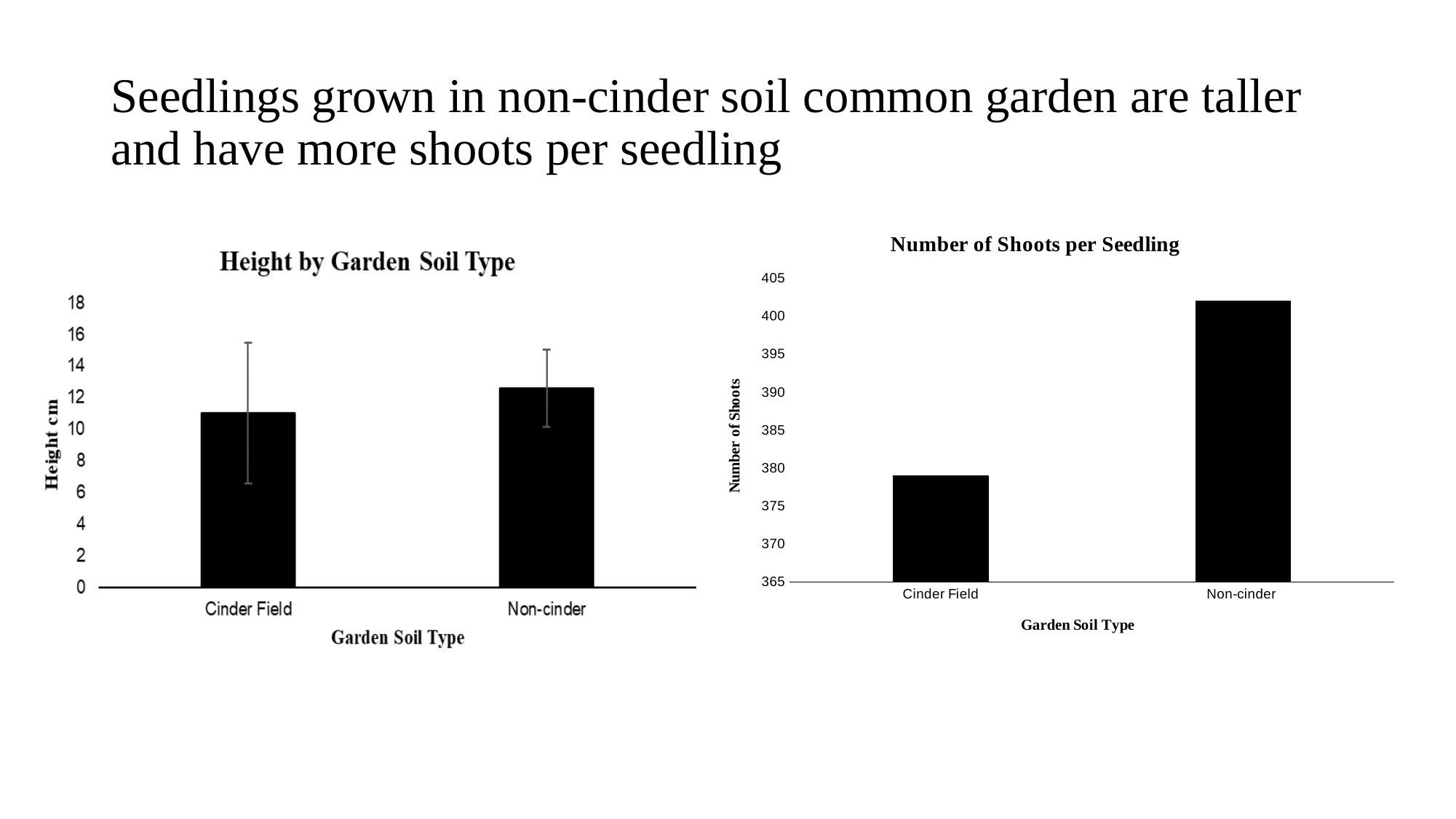
In the 'Number of Shoots per Seedling' chart, how many categories are shown on the x axis? 2 In the 'Height by Garden Soil Type' chart, what kind of chart is shown? bar chart In the 'Number of Shoots per Seedling' chart, which garden soil type has the lowest number of shoots? Cinder Field In the 'Number of Shoots per Seedling' chart, what kind of chart is shown? bar chart In the 'Height by Garden Soil Type' chart, which garden soil type has the taller bar? Non-cinder In the 'Number of Shoots per Seedling' chart, which garden soil type has the highest number of shoots? Non-cinder In the 'Number of Shoots per Seedling' chart, is the value for Non-cinder greater or less than 400? greater In the 'Height by Garden Soil Type' chart, what is the label on the y axis? Height cm In the 'Height by Garden Soil Type' chart, how many garden soil types are plotted? 2 In the 'Height by Garden Soil Type' chart, is the height for Cinder Field greater or less than 10? greater In the 'Number of Shoots per Seedling' chart, what is the label on the x axis? Garden Soil Type